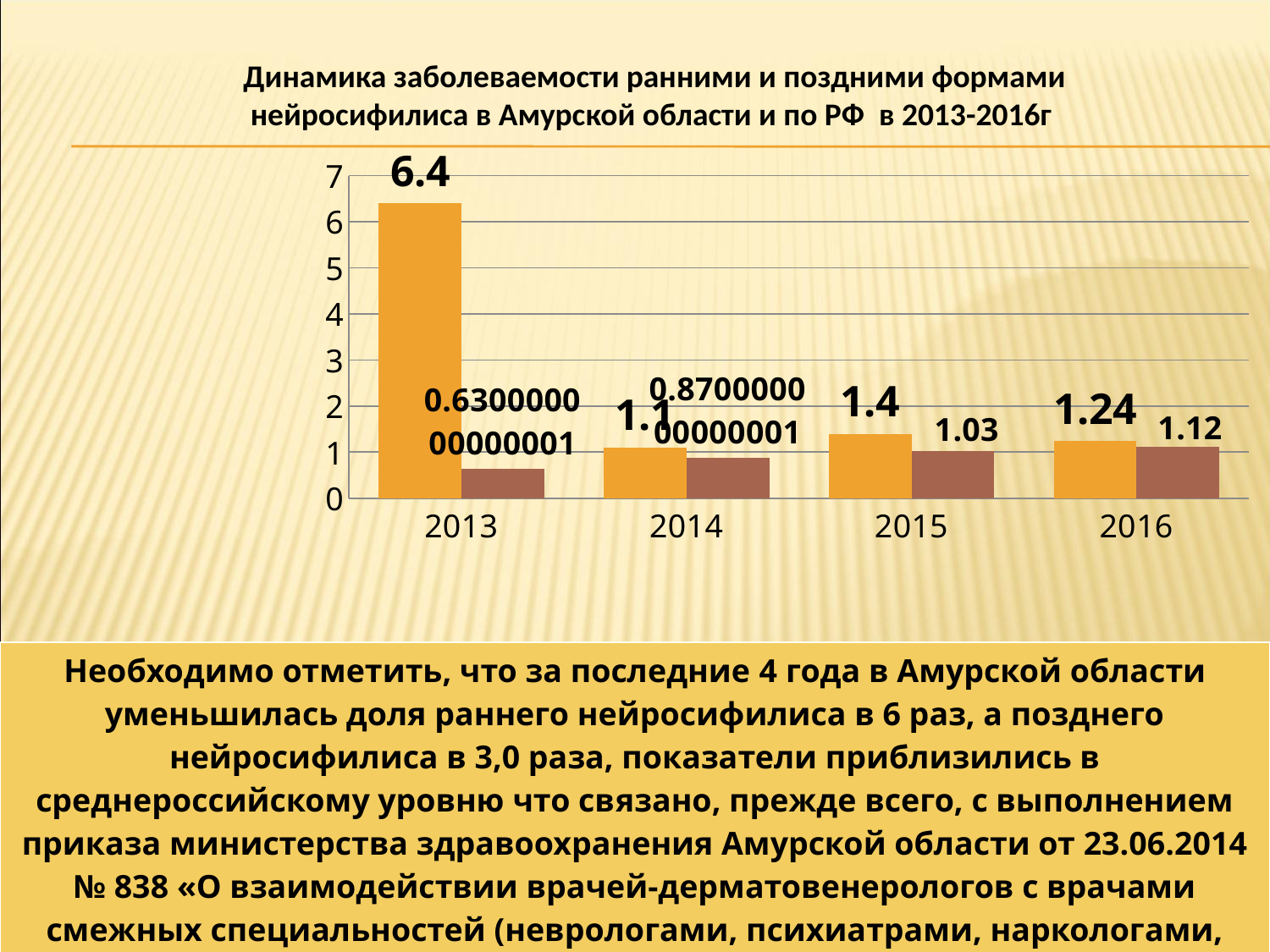
In which year is the orange bar lowest? 2014 In 2016, which bar is larger, the orange or the brown one? orange How many years are shown on the x axis? 4 In which year is the orange bar highest? 2013 What is the value of the orange bar for 2013? 6.4 What is the value of the brown bar for 2016? 1.12 In which year is the brown bar highest? 2016 What is the value of the orange bar for 2014? 1.1 Is the value of the orange bar for 2013 greater or less than 6? greater Do the brown bars rise or fall from 2013 to 2016? rise What is the difference between the orange and brown bars in 2015? 0.37 What is the value of the brown bar for 2015? 1.03